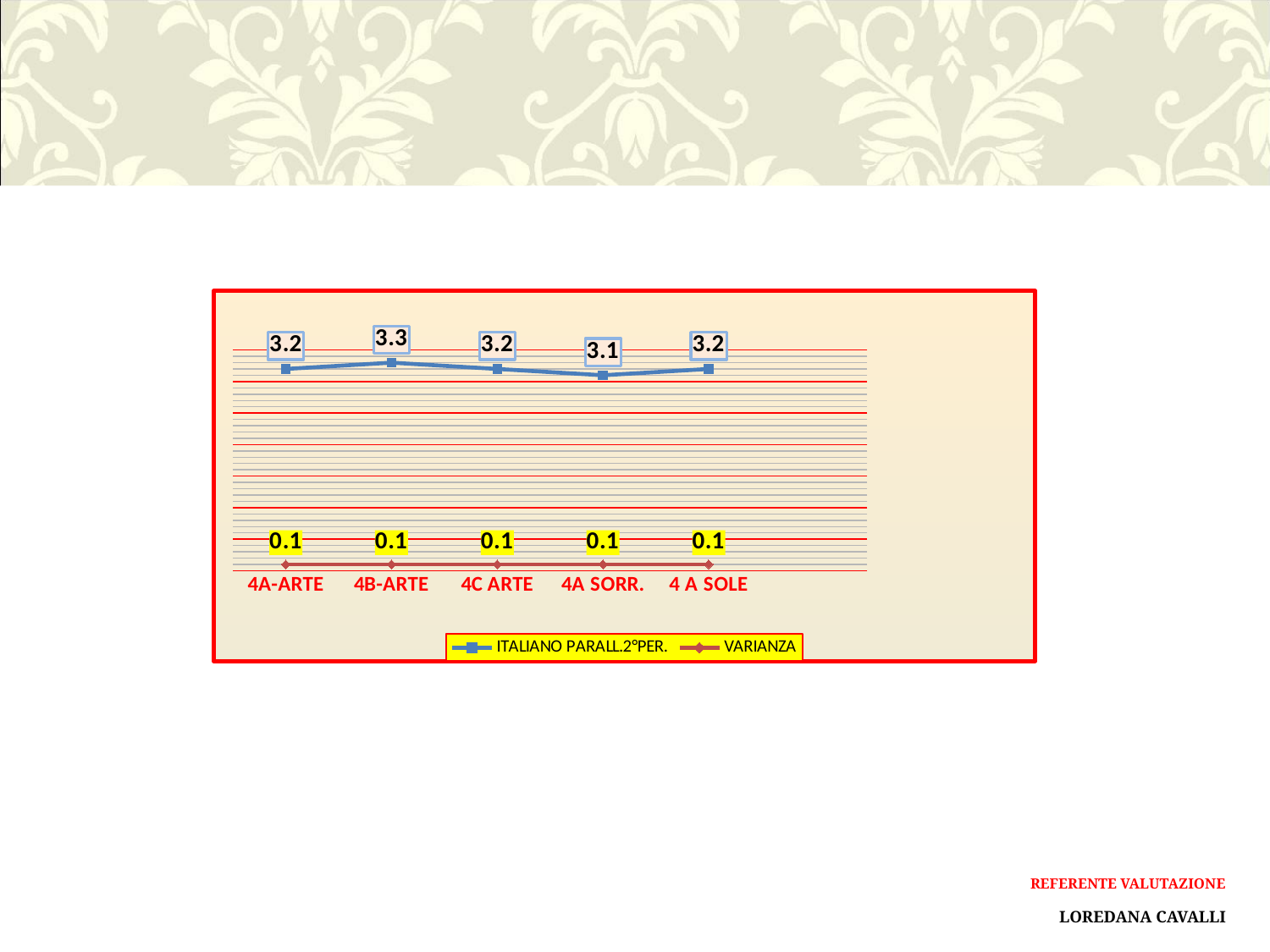
What is the difference between the ITALIANO PARALL.2°PER. values for 4B-ARTE and 4A SORR.? 0.2 What kind of chart is shown on the slide? Line chart How many categories are shown on the x axis? 5 Does the VARIANZA series change across the categories? No, it stays at 0.1 What is the value of ITALIANO PARALL.2°PER. for 4B-ARTE? 3.3 Which category has the lowest ITALIANO PARALL.2°PER. value? 4A SORR. What is the VARIANZA value for 4C ARTE? 0.1 Which category has the highest ITALIANO PARALL.2°PER. value? 4B-ARTE Which is larger, the ITALIANO PARALL.2°PER. value for 4B-ARTE or for 4C ARTE? 4B-ARTE What is the value of ITALIANO PARALL.2°PER. for 4A SORR.? 3.1 How many series does the legend list? 2 What are the two series named in the legend? ITALIANO PARALL.2°PER. and VARIANZA